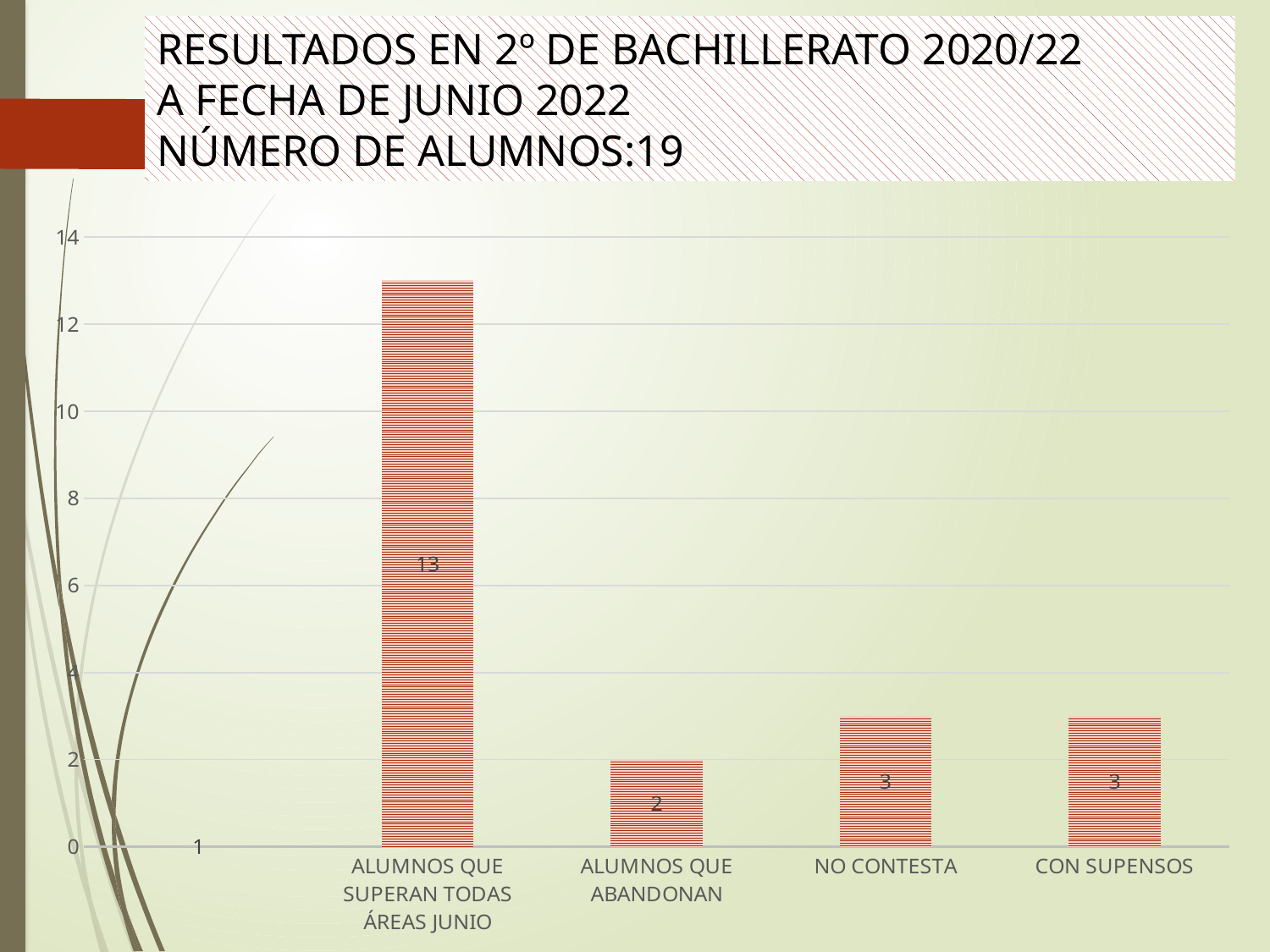
Is the value for ALUMNOS QUE SUPERAN TODAS ÁREAS JUNIO greater or less than 10? greater What is the difference between the values for ALUMNOS QUE SUPERAN TODAS ÁREAS JUNIO and NO CONTESTA? 10 What is the value for CON SUPENSOS? 3 Which category has the lowest value among the labelled bars? ALUMNOS QUE ABANDONAN According to the slide title, how many students (alumnos) are there? 19 What is the value for ALUMNOS QUE ABANDONAN? 2 What is the value for NO CONTESTA? 3 What is the value for ALUMNOS QUE SUPERAN TODAS ÁREAS JUNIO? 13 Which category has the highest value? ALUMNOS QUE SUPERAN TODAS ÁREAS JUNIO What is the difference between the values for ALUMNOS QUE SUPERAN TODAS ÁREAS JUNIO and ALUMNOS QUE ABANDONAN? 11 What kind of chart is shown on the slide? bar chart Which is larger, the value for NO CONTESTA or the value for ALUMNOS QUE ABANDONAN? NO CONTESTA